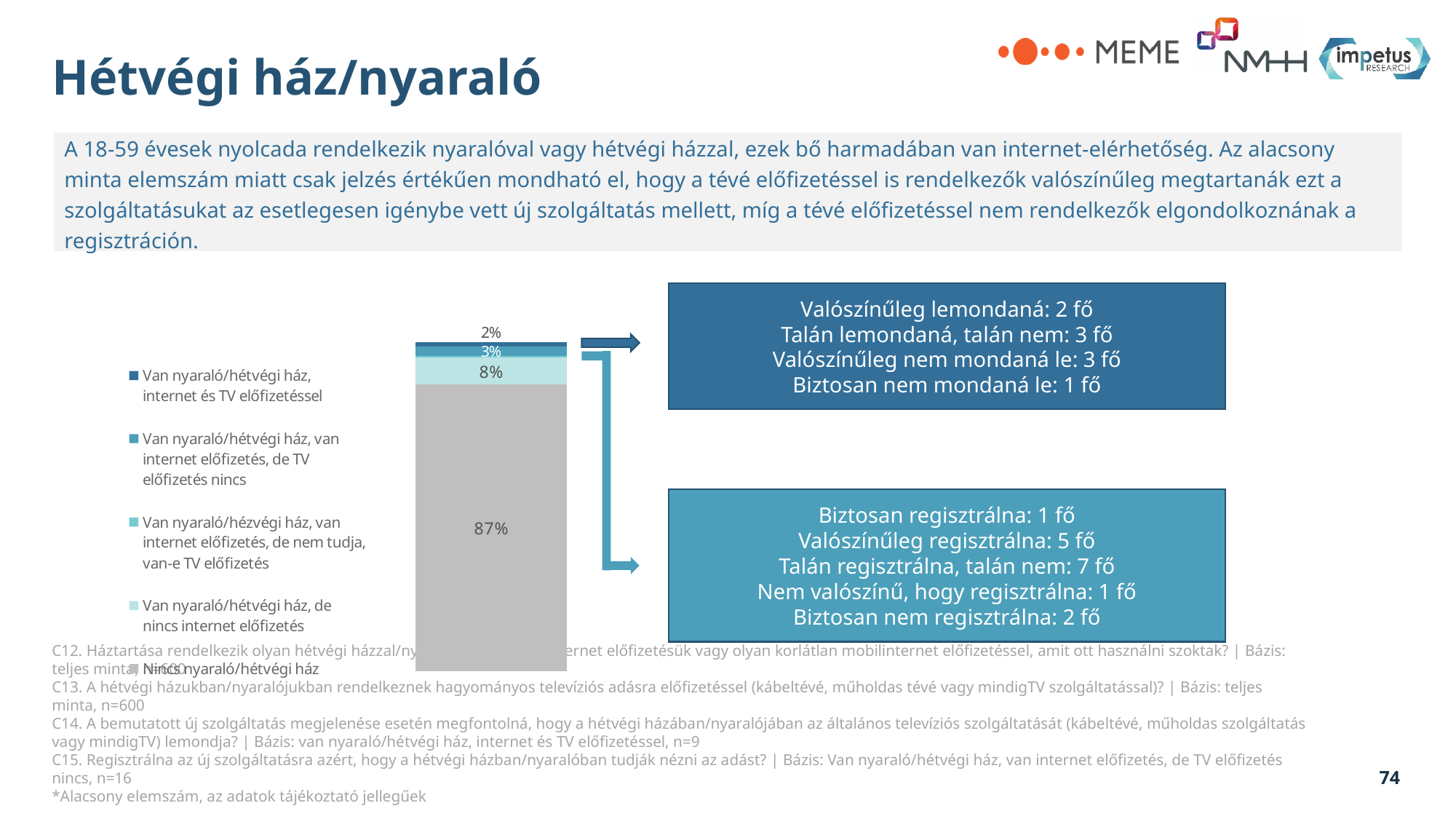
What percentage is shown for the largest segment of the bar? 87% Which legend category corresponds to the 87% segment of the bar? Nincs nyaraló/hétvégi ház What is the value of the segment for 'Van nyaraló/hétvégi ház, internet és TV előfizetéssel'? 2% How many entries does the legend list? 5 What kind of chart is shown on the slide? stacked bar chart Which segment of the bar has the highest value? Nincs nyaraló/hétvégi ház (87%) What percentage is shown for the topmost segment of the bar? 2% What is the difference between the 87% segment and the 2% segment? 85 percentage points What colour is the largest segment of the bar? gray Which is larger, the 3% segment or the 8% segment? the 8% segment What is the total of all the labelled segments in the stacked bar? 100%